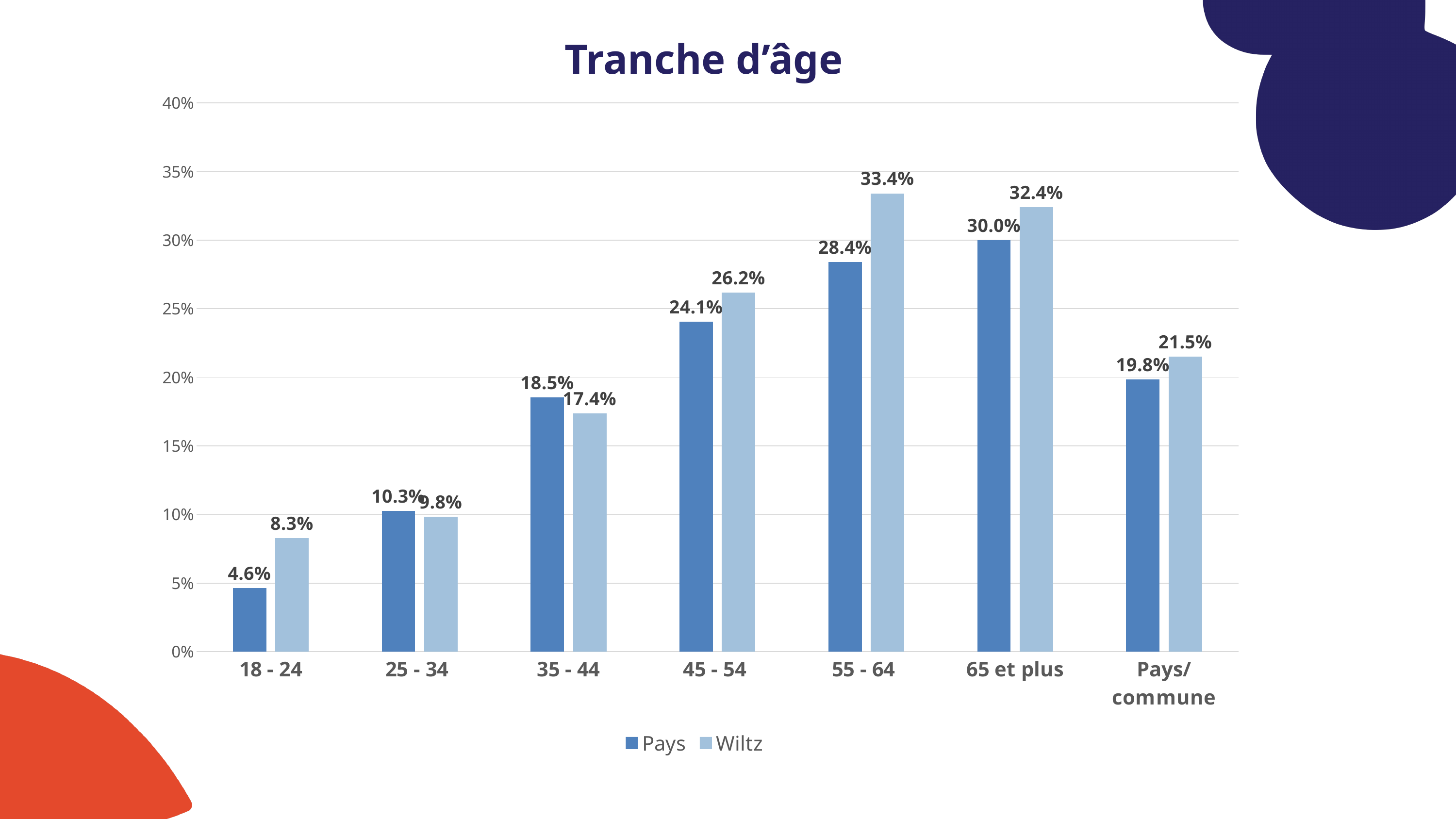
Is the value for Pays in the 45 - 54 age group greater or less than 25%? less How many categories are shown on the x axis? 7 What is the value for Wiltz in the 55 - 64 age group? 33.4% What is the title of the chart? Tranche d'âge What is the value for Pays in the 18 - 24 age group? 4.6% Which age group has the highest value for Wiltz? 55 - 64 What is the value for Wiltz in the Pays/commune category? 21.5% How many series does the legend list? 2 What is the difference between Wiltz and Pays in the 65 et plus age group? 2.4% Which category has the lowest value for Pays? 18 - 24 What kind of chart is shown on the slide? bar chart Which is larger in the 35 - 44 age group, Pays or Wiltz? Pays